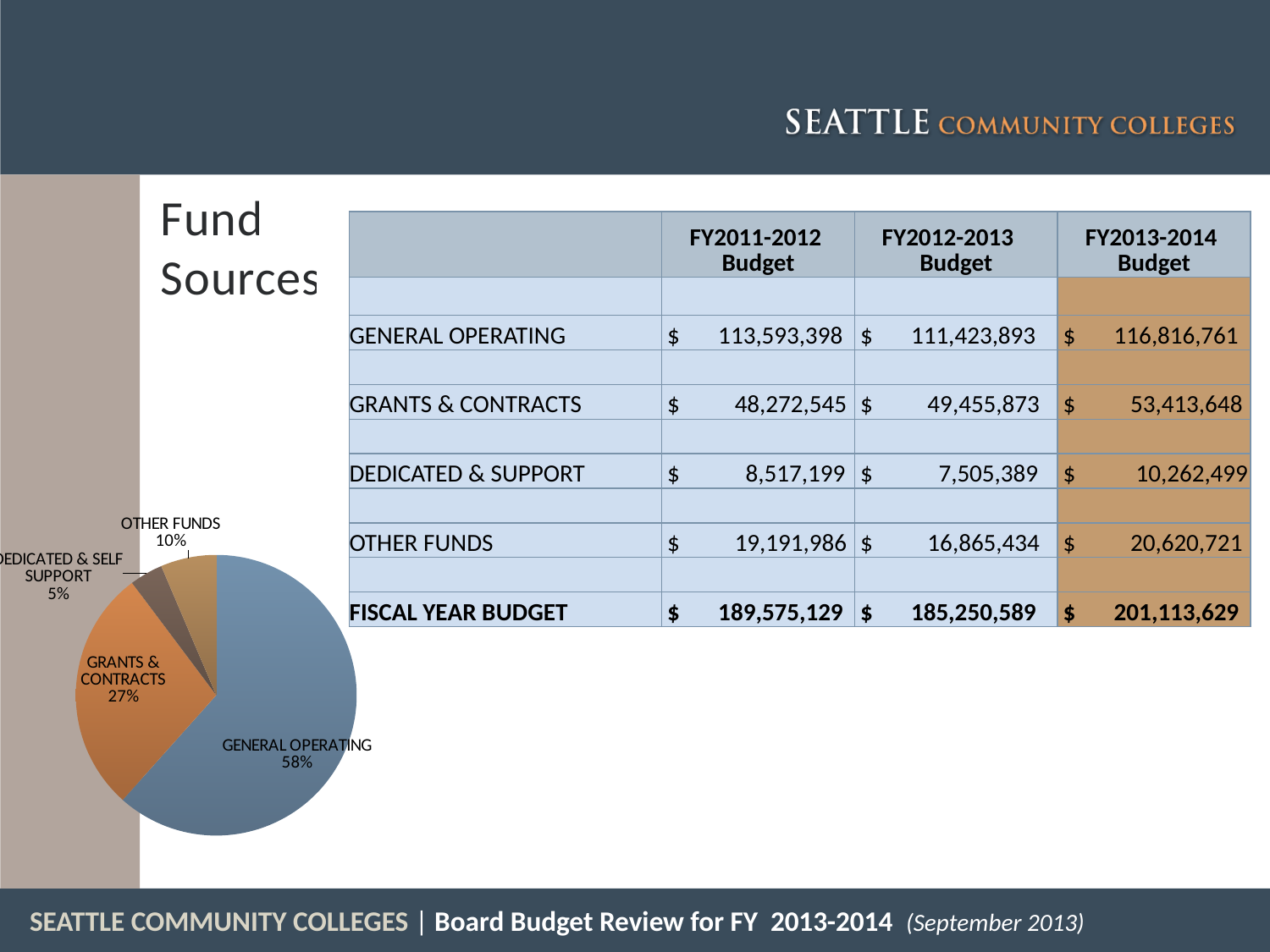
What is the difference in percentage points between the General Operating and Grants & Contracts slices of the pie chart? 31 In the pie chart, which is larger: Grants & Contracts or Other Funds? Grants & Contracts What is the title shown next to the pie chart on the slide? Fund Sources What share of the pie chart does Grants & Contracts represent? 27% What share of the pie chart does Dedicated & Self Support represent? 5% Which slice of the pie chart is the smallest? Dedicated & Self Support What share of the pie chart does Other Funds represent? 10% How many slices does the pie chart have? 4 What is the difference in percentage points between the Other Funds and Dedicated & Self Support slices of the pie chart? 5 What kind of chart is shown on the slide? pie chart Which slice of the pie chart is the largest? General Operating